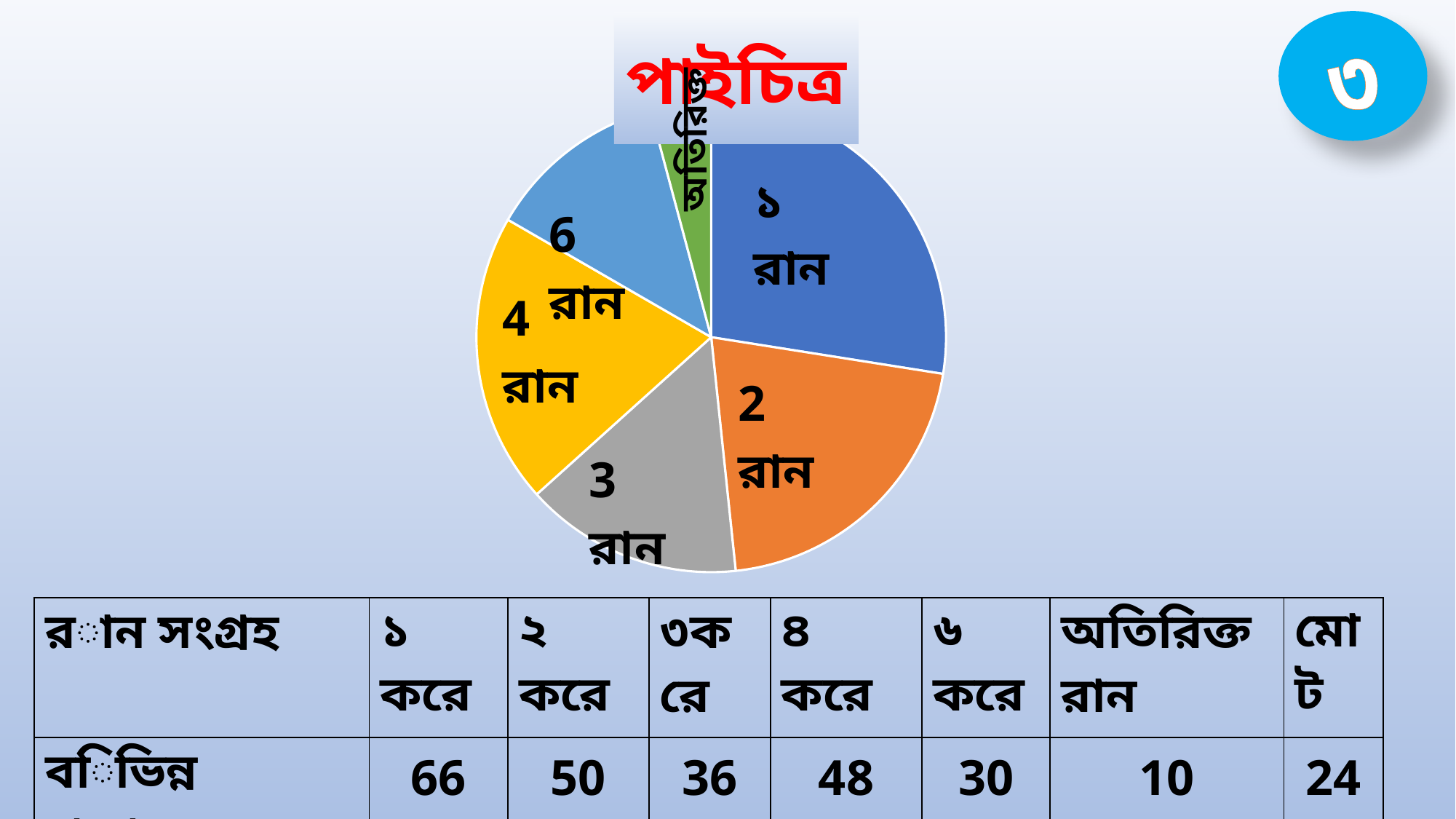
What is the title of the chart? পাইচিত্র What colour is the ১ রান slice of the pie chart? blue According to the table below the pie chart, what is the value for ১ করে? 66 Which slice is larger in the pie chart, ১ রান or 6 রান? ১ রান Which slice of the pie chart is the largest? ১ রান According to the table below the pie chart, what is the difference between the values for ১ করে and ২ করে? 16 How many slices does the pie chart have? 6 Which slice of the pie chart is the smallest? অতিরিক্ত What kind of chart is shown on the slide? pie chart Which slice is larger in the pie chart, 2 রান or 3 রান? 2 রান According to the table below the pie chart, what is the value for অতিরিক্ত রান? 10 Which slice is larger in the pie chart, 4 রান or 6 রান? 4 রান